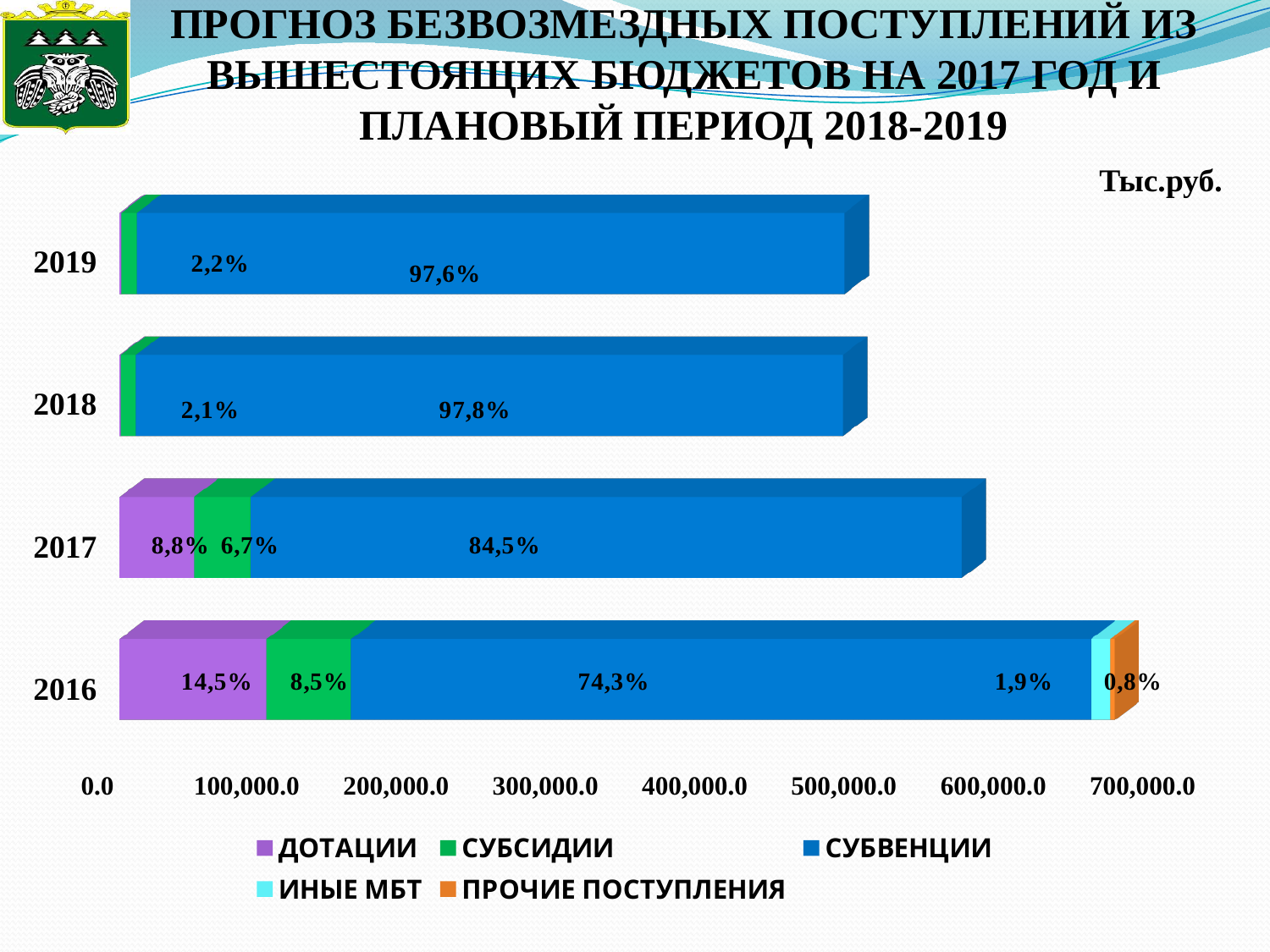
What is the share of СУБВЕНЦИИ in 2016? 74,3% What is the share of ПРОЧИЕ ПОСТУПЛЕНИЯ in 2016? 0,8% Which year has the longest total bar? 2016 Which is larger: the share of СУБВЕНЦИИ in 2017 or in 2016? 2017 What kind of chart is shown on the slide? bar chart What is the share of ДОТАЦИИ in 2017? 8,8% What is the share of СУБСИДИИ in 2019? 2,2% How many years (categories) are plotted on the chart? 4 What is the share of СУБВЕНЦИИ in 2018? 97,8% What is the difference between the share of ДОТАЦИИ in 2016 and in 2017? 5,7% How many series does the legend list? 5 Is the total bar for 2016 greater or less than 600,000.0? greater